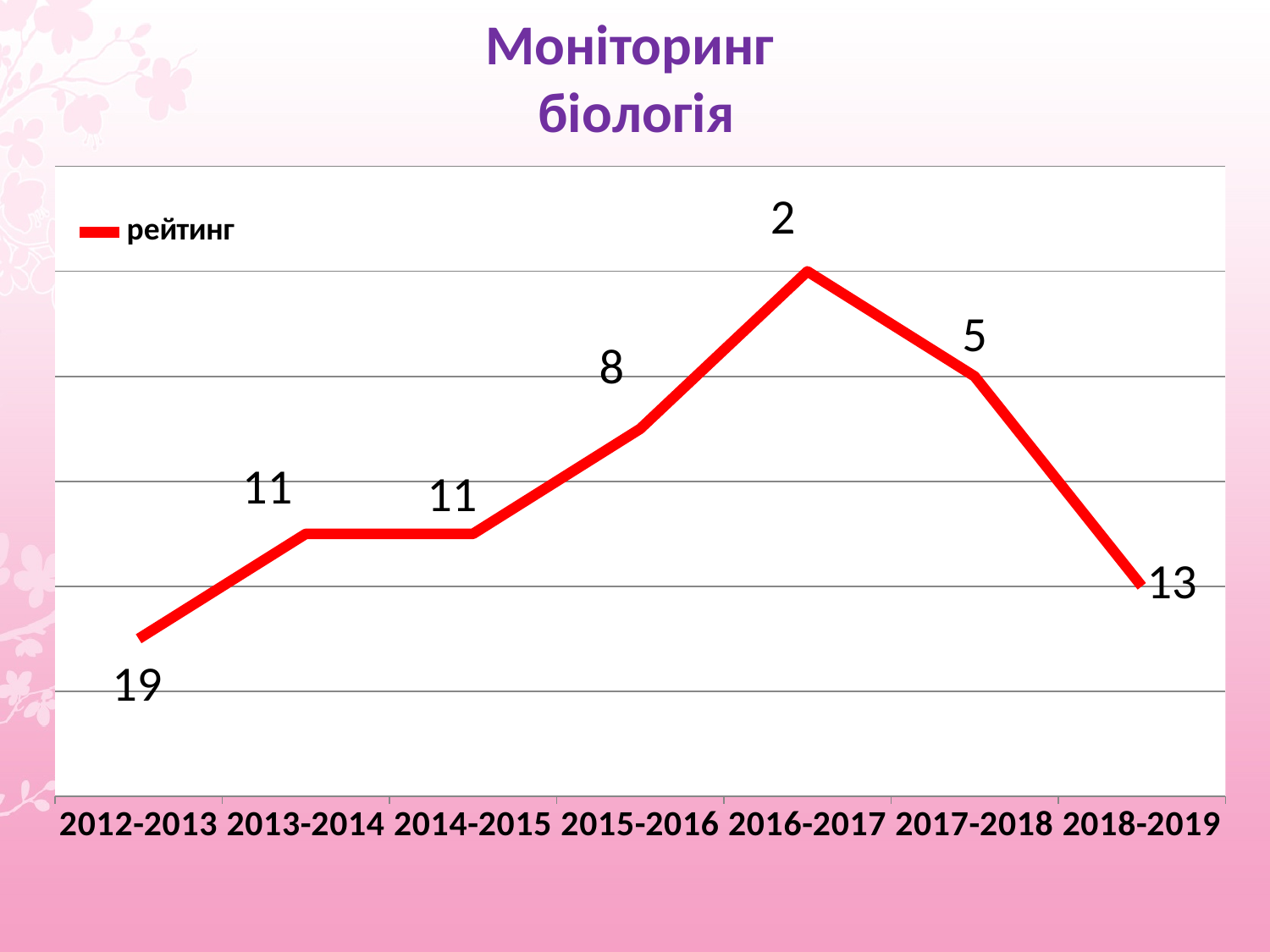
Which year has the highest labelled value? 2012-2013 Which year has the lowest labelled value? 2016-2017 What kind of chart is this? line chart What is the name of the series in the legend? рейтинг How many years are shown on the x axis? 7 What is the value for 2016-2017? 2 What is the value for 2015-2016? 8 What is the value for 2018-2019? 13 What is the difference between the values for 2012-2013 and 2018-2019? 6 How many series does the legend list? 1 What is the value for 2012-2013? 19